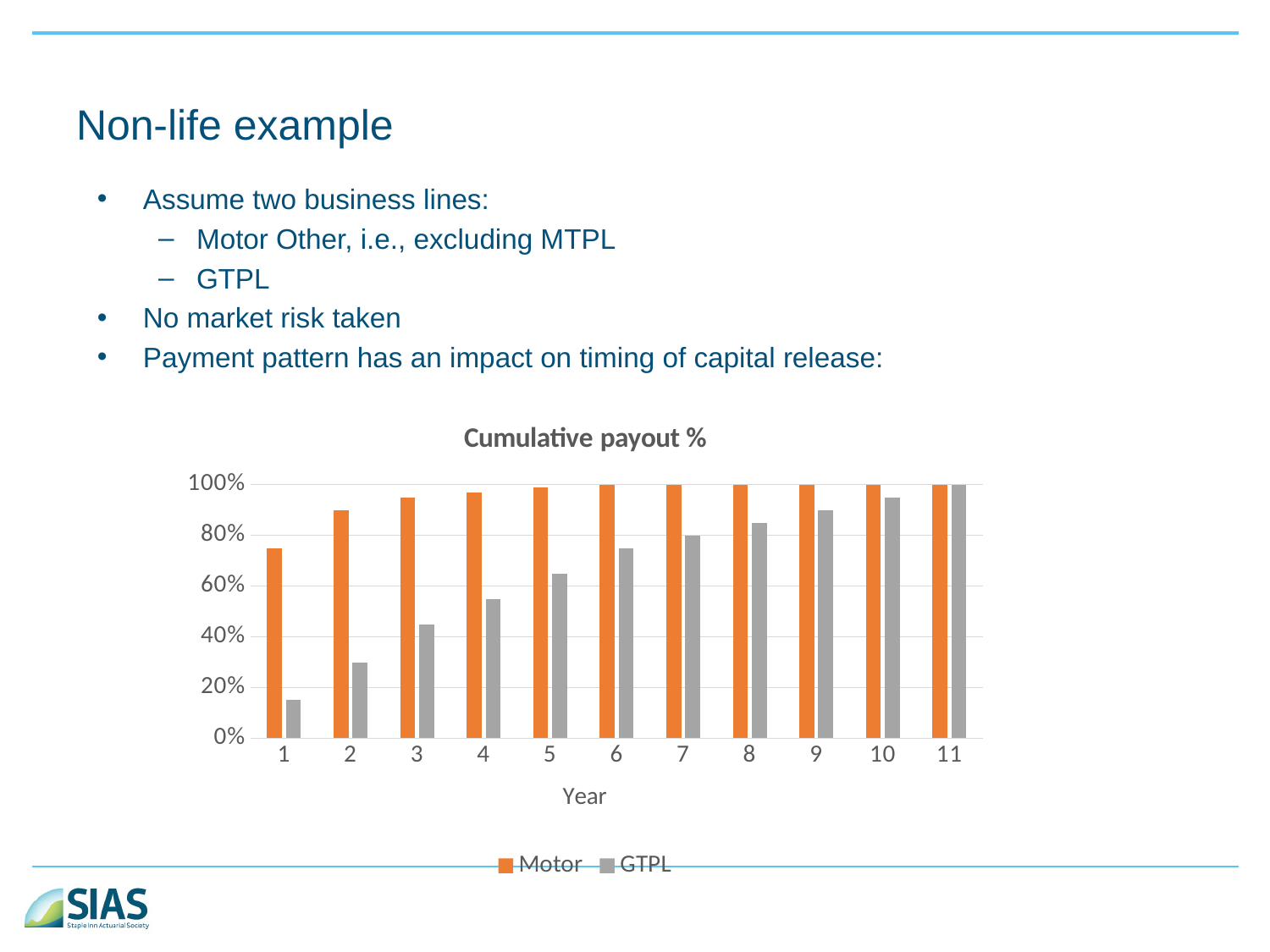
In year 1, which series has the larger cumulative payout, Motor or GTPL? Motor How many series does the legend of the Cumulative payout % chart list? 2 Is the GTPL value for year 9 greater or less than 80%? greater Is the GTPL value for year 1 greater or less than 20%? less What is the label of the x axis of the chart? Year In which year is the GTPL cumulative payout lowest? 1 What is the title of the chart? Cumulative payout % Is the Motor value for year 1 greater or less than 80%? less Do the GTPL values rise or fall from year 1 to year 11? rise How many years are shown on the x axis of the Cumulative payout % chart? 11 What kind of chart is shown on the slide? bar chart